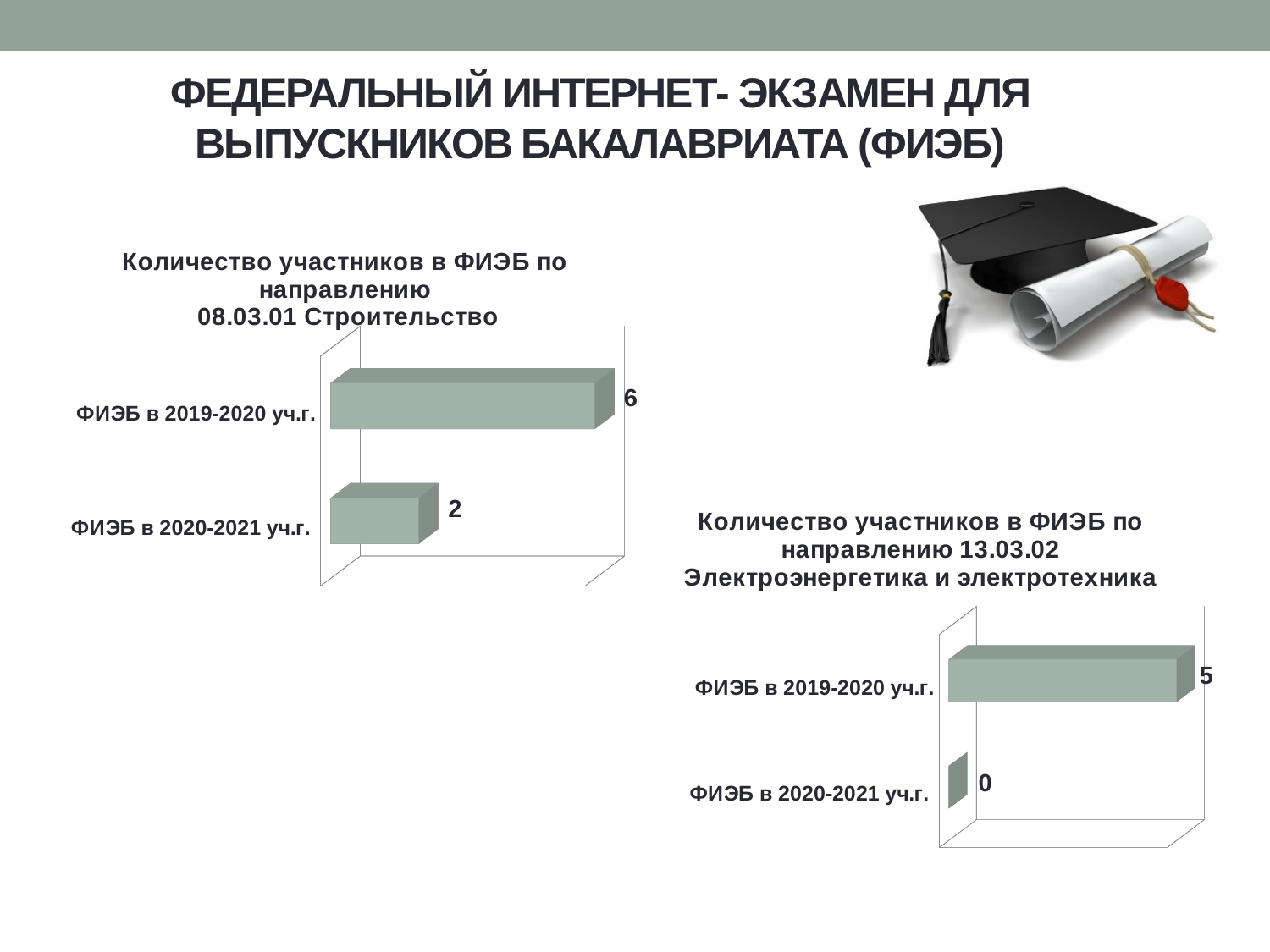
In the chart for 13.03.02 Электроэнергетика и электротехника, what is the difference between the values for ФИЭБ в 2019-2020 уч.г. and ФИЭБ в 2020-2021 уч.г.? 5 How many charts are on the slide? 2 In the chart for 13.03.02 Электроэнергетика и электротехника, which category has the lowest value? ФИЭБ в 2020-2021 уч.г. In the chart titled "Количество участников в ФИЭБ по направлению 13.03.02 Электроэнергетика и электротехника", what is the value for ФИЭБ в 2020-2021 уч.г.? 0 Which is larger: the value for ФИЭБ в 2019-2020 уч.г. in the 08.03.01 Строительство chart or the value for ФИЭБ в 2019-2020 уч.г. in the 13.03.02 Электроэнергетика и электротехника chart? 08.03.01 Строительство In the chart for 08.03.01 Строительство, which category has the highest value? ФИЭБ в 2019-2020 уч.г. How many categories are shown in the chart for 08.03.01 Строительство? 2 What kind of chart is the chart for 13.03.02 Электроэнергетика и электротехника? Bar chart In the chart titled "Количество участников в ФИЭБ по направлению 13.03.02 Электроэнергетика и электротехника", what is the value for ФИЭБ в 2019-2020 уч.г.? 5 In the chart for 08.03.01 Строительство, what is the difference between the values for ФИЭБ в 2019-2020 уч.г. and ФИЭБ в 2020-2021 уч.г.? 4 In the chart titled "Количество участников в ФИЭБ по направлению 08.03.01 Строительство", what is the value for ФИЭБ в 2020-2021 уч.г.? 2 In the chart titled "Количество участников в ФИЭБ по направлению 08.03.01 Строительство", what is the value for ФИЭБ в 2019-2020 уч.г.? 6